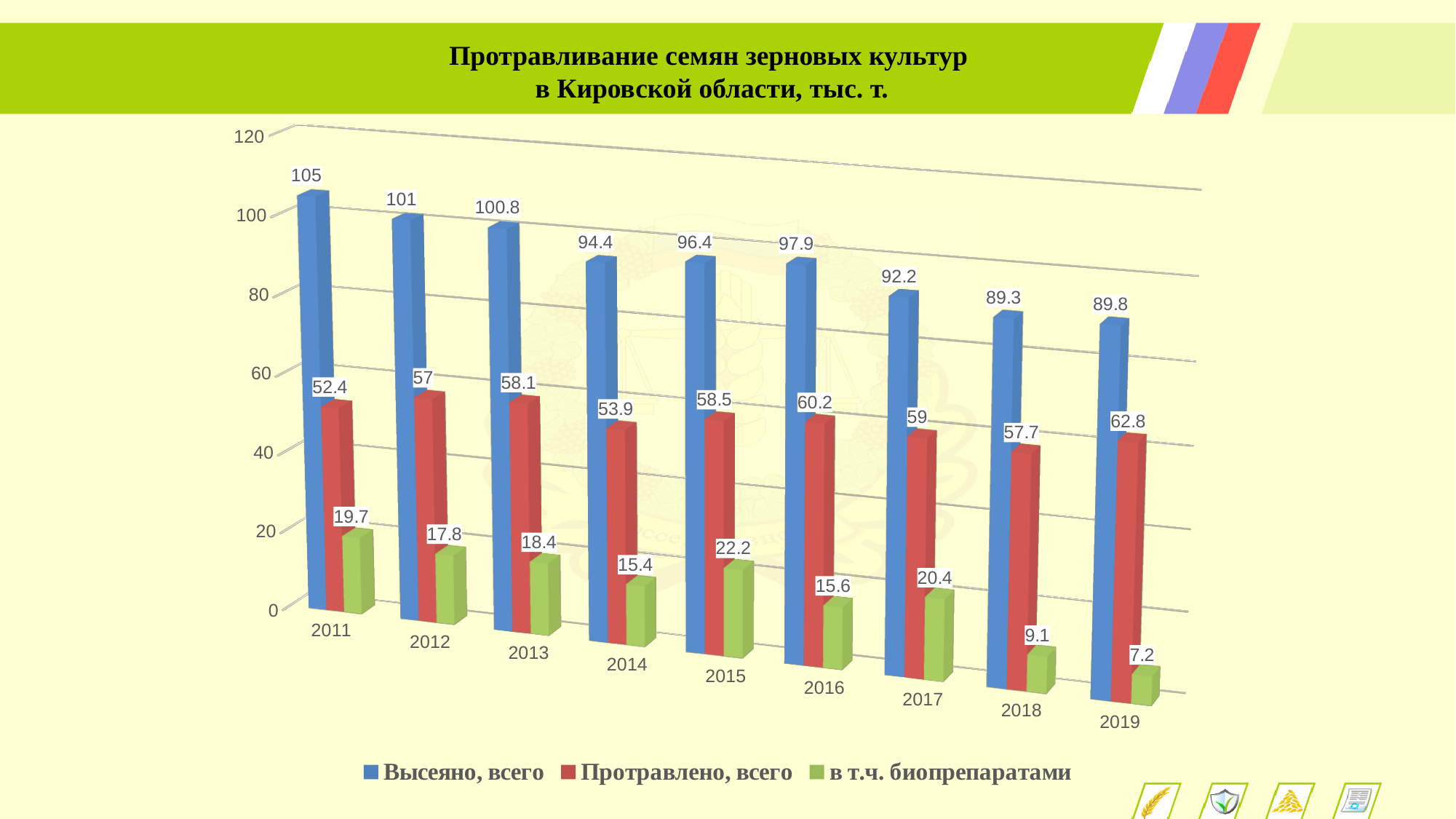
What is the value for "Протравлено, всего" in 2019? 62.8 Which year has the highest value for "Высеяно, всего"? 2011 How many years are shown on the x axis? 9 Which year has the lowest value for "в т.ч. биопрепаратами"? 2019 What kind of chart is shown on the slide? bar chart What is the value for "в т.ч. биопрепаратами" in 2015? 22.2 Which is larger: "Протравлено, всего" in 2016 or in 2017? 2016 What is the difference between "Высеяно, всего" and "Протравлено, всего" in 2018? 31.6 What colour represents "Протравлено, всего" in the chart? red What is the value for "Высеяно, всего" in 2011? 105 Does the value for "в т.ч. биопрепаратами" rise or fall from 2017 to 2019? fall How many series does the legend list? 3